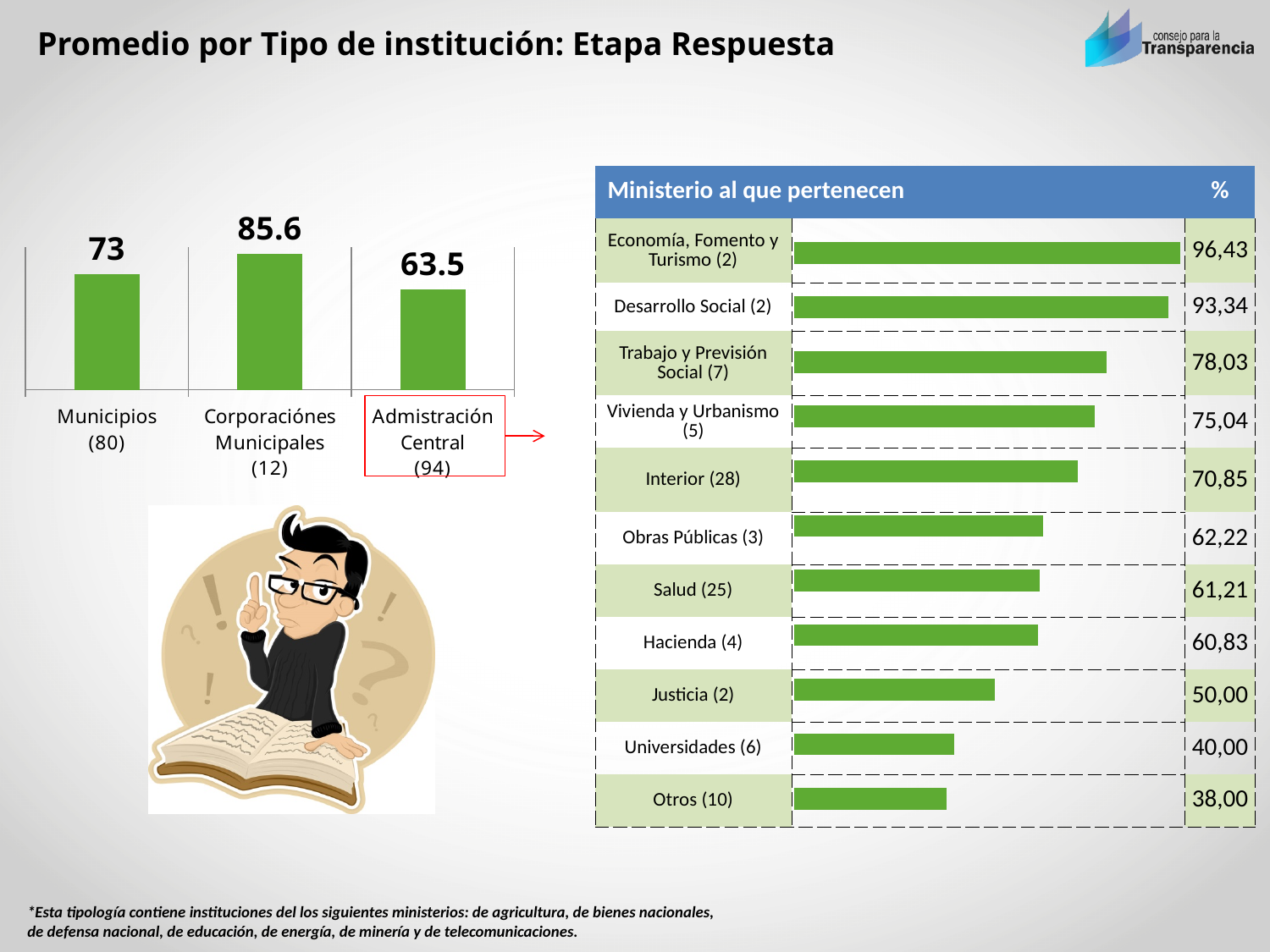
In the bar chart on the left, how many categories are shown? 3 In the chart on the right titled 'Ministerio al que pertenecen', which ministry has the lowest percentage? Otros (10) In the chart on the right titled 'Ministerio al que pertenecen', what is the percentage for Interior (28)? 70,85 In the bar chart on the left, what is the value for Corporaciónes Municipales (12)? 85.6 In the bar chart on the left, which category has the highest value? Corporaciónes Municipales (12) What kind of chart is the chart on the left? bar chart In the bar chart on the left, which category has the lowest value? Admistración Central (94) In the chart on the right titled 'Ministerio al que pertenecen', which ministry has the highest percentage? Economía, Fomento y Turismo (2) In the bar chart on the left, what is the difference between the values for Corporaciónes Municipales (12) and Admistración Central (94)? 22.1 In the bar chart on the left, what is the value for Municipios (80)? 73 In the chart on the right titled 'Ministerio al que pertenecen', which is larger: the percentage for Salud (25) or Hacienda (4)? Salud (25) In the chart on the right titled 'Ministerio al que pertenecen', how many ministries are listed? 11